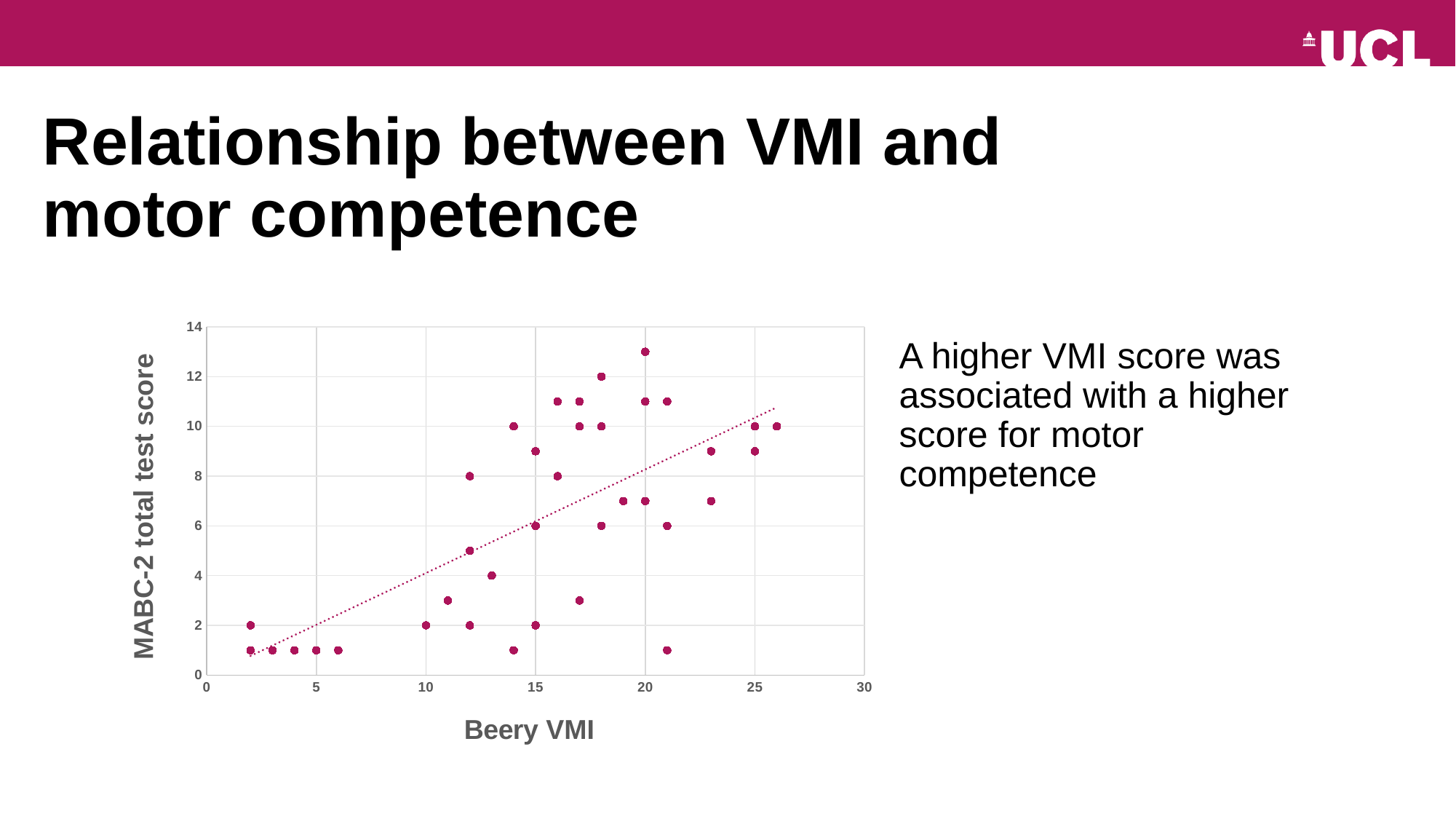
Is the Beery VMI value of the rightmost point greater or less than 25? greater Do the MABC-2 total test scores tend to rise or fall as Beery VMI increases? Rise What is the MABC-2 total test score of the rightmost point on the chart? 10 Which has a higher MABC-2 total test score: the highest point at Beery VMI 20 or the highest point at Beery VMI 25? The point at Beery VMI 20 What is the label of the x axis? Beery VMI Is the MABC-2 total test score of the lowest points on the chart greater or less than 2? less Is the Beery VMI value of the leftmost point greater or less than 5? less What is the maximum value shown on the y axis? 14 What kind of chart is shown on the slide? Scatter plot What is the label of the y axis? MABC-2 total test score What is the MABC-2 total test score of the point at Beery VMI 10? 2